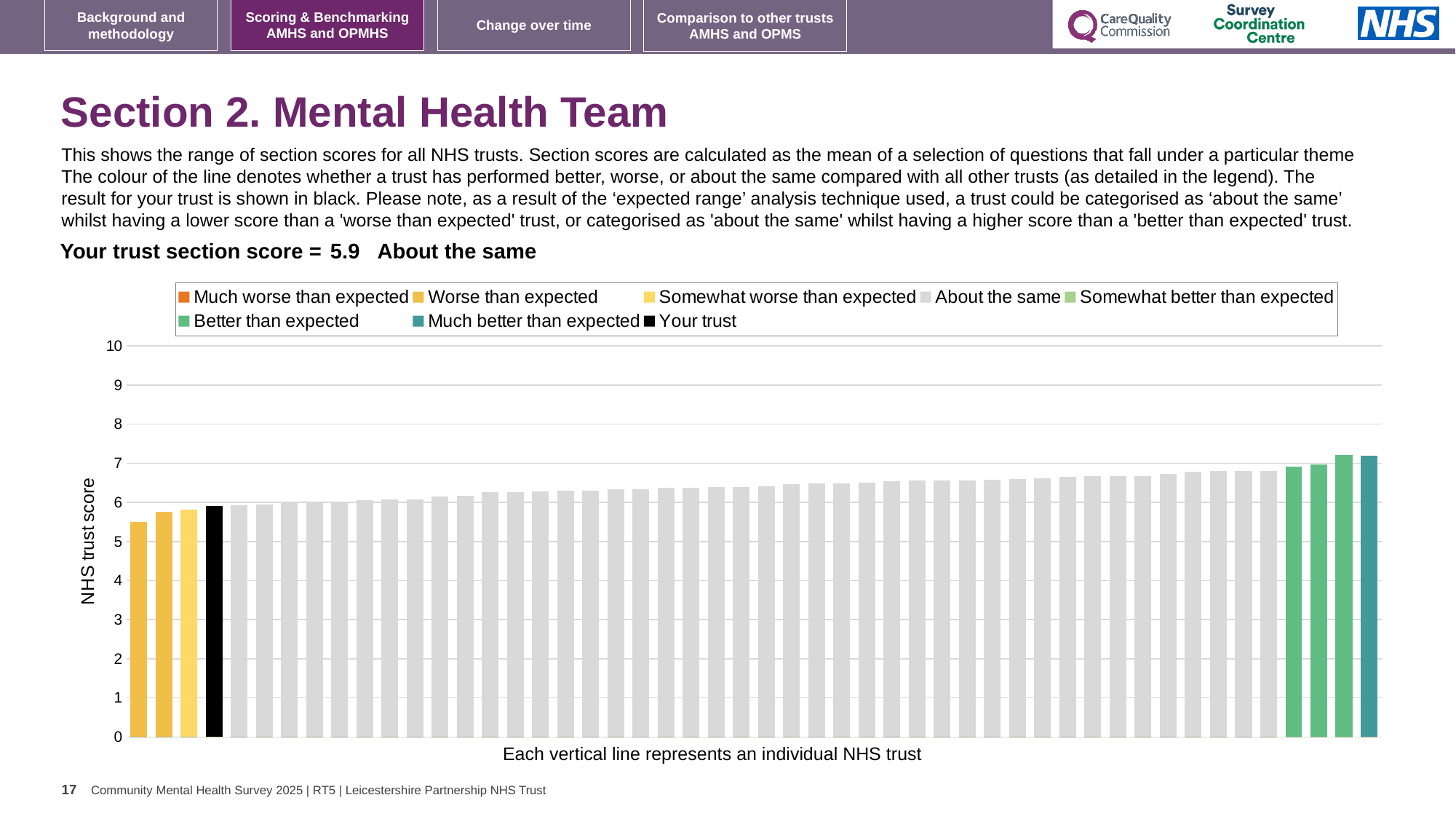
How many bars are coloured as 'Worse than expected'? 2 How many entries does the chart legend list? 8 How many bars are coloured as 'Much better than expected'? 1 Is the value of the tallest bar greater or less than 6? greater Is the value of the black 'Your trust' bar greater or less than 5? greater Which category is your trust placed in for this section? About the same What is the label on the vertical axis of the chart? NHS trust score Which is larger: the 'Your trust' bar or the leftmost bar? Your trust Do the bar values rise or fall moving from left to right along the x axis? Rise What kind of chart is shown on the slide? Bar chart What is the section score for your trust? 5.9 Is the value of the leftmost (lowest) bar greater or less than 6? less